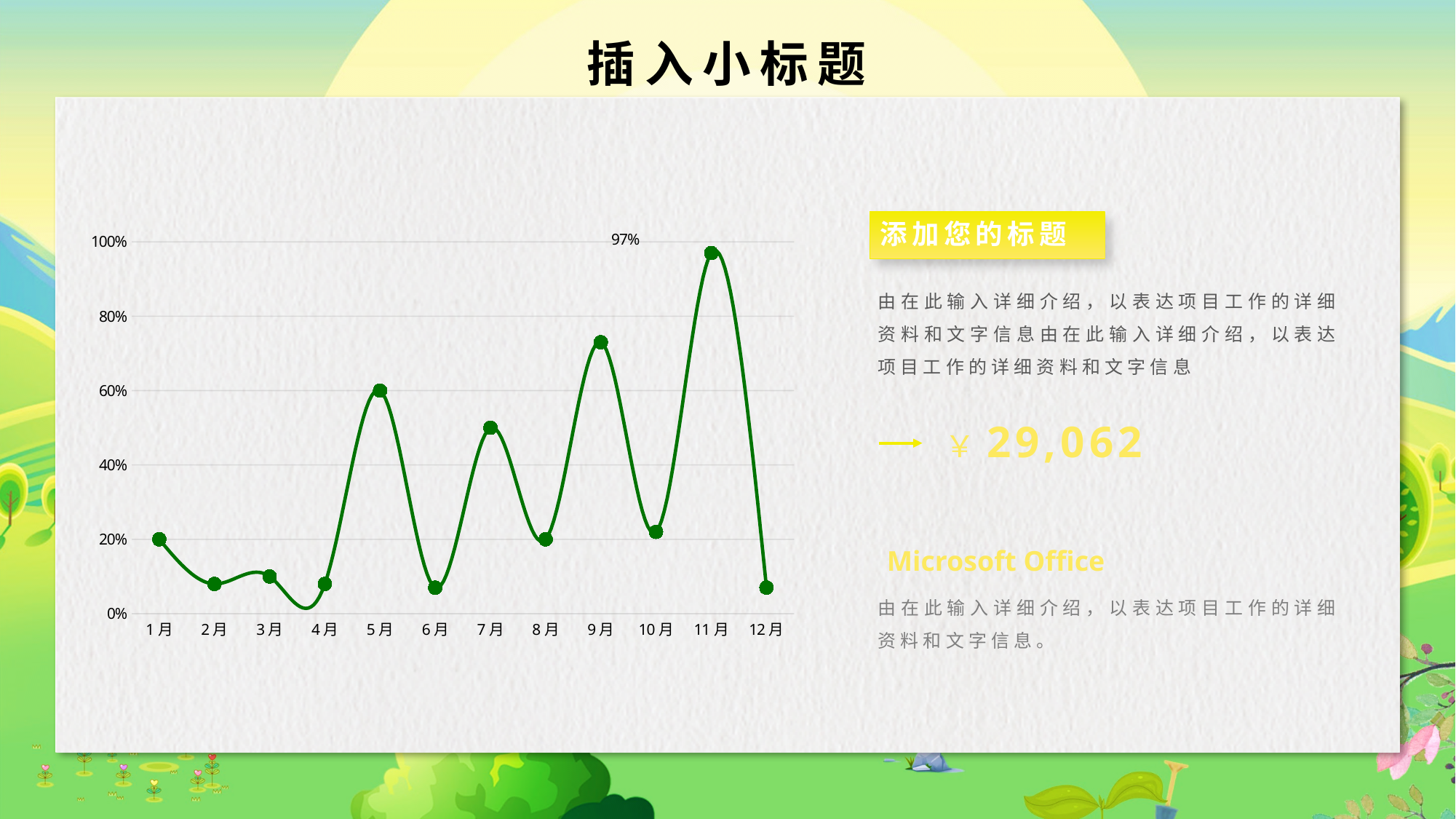
Does the line rise or fall from 11月 to 12月? fall What colour is the line in the chart? green How many months are plotted on the x axis of the chart? 12 Is the value for 7月 greater or less than 40%? greater Which is larger, the value for 5月 or the value for 7月? 5月 Is the value for 12月 greater or less than 20%? less What is the value shown for 11月? 97% What kind of chart is shown on the slide? line chart Which is larger, the value for 9月 or the value for 10月? 9月 Is the value for 6月 greater or less than 20%? less Which month has the highest value in the chart? 11月